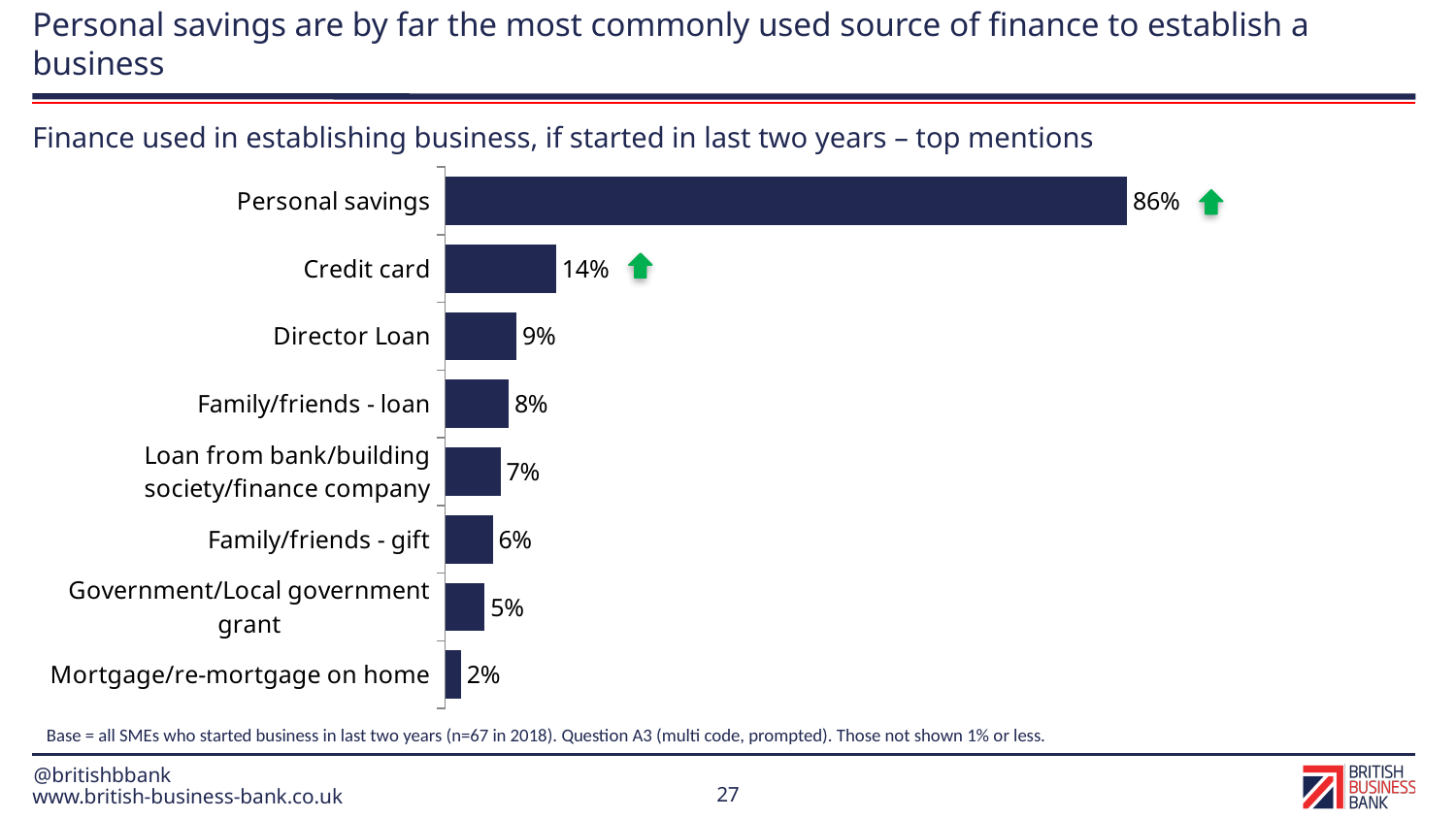
Which source of finance has the lowest value? Mortgage/re-mortgage on home What is the value for Government/Local government grant? 5% Which is larger, the value for Family/friends - loan or Family/friends - gift? Family/friends - loan What is the value shown for Credit card? 14% How many sources of finance are shown in the chart? 8 Which source of finance has the highest value? Personal savings What type of chart is shown on the slide? Bar chart What is the difference between the values for Personal savings and Credit card? 72 percentage points What is the difference between the values for Director Loan and Mortgage/re-mortgage on home? 7 percentage points What percentage of SMEs used personal savings to establish their business? 86% Which two categories have a green upward arrow next to their value? Personal savings and Credit card What percentage is shown for Director Loan? 9%